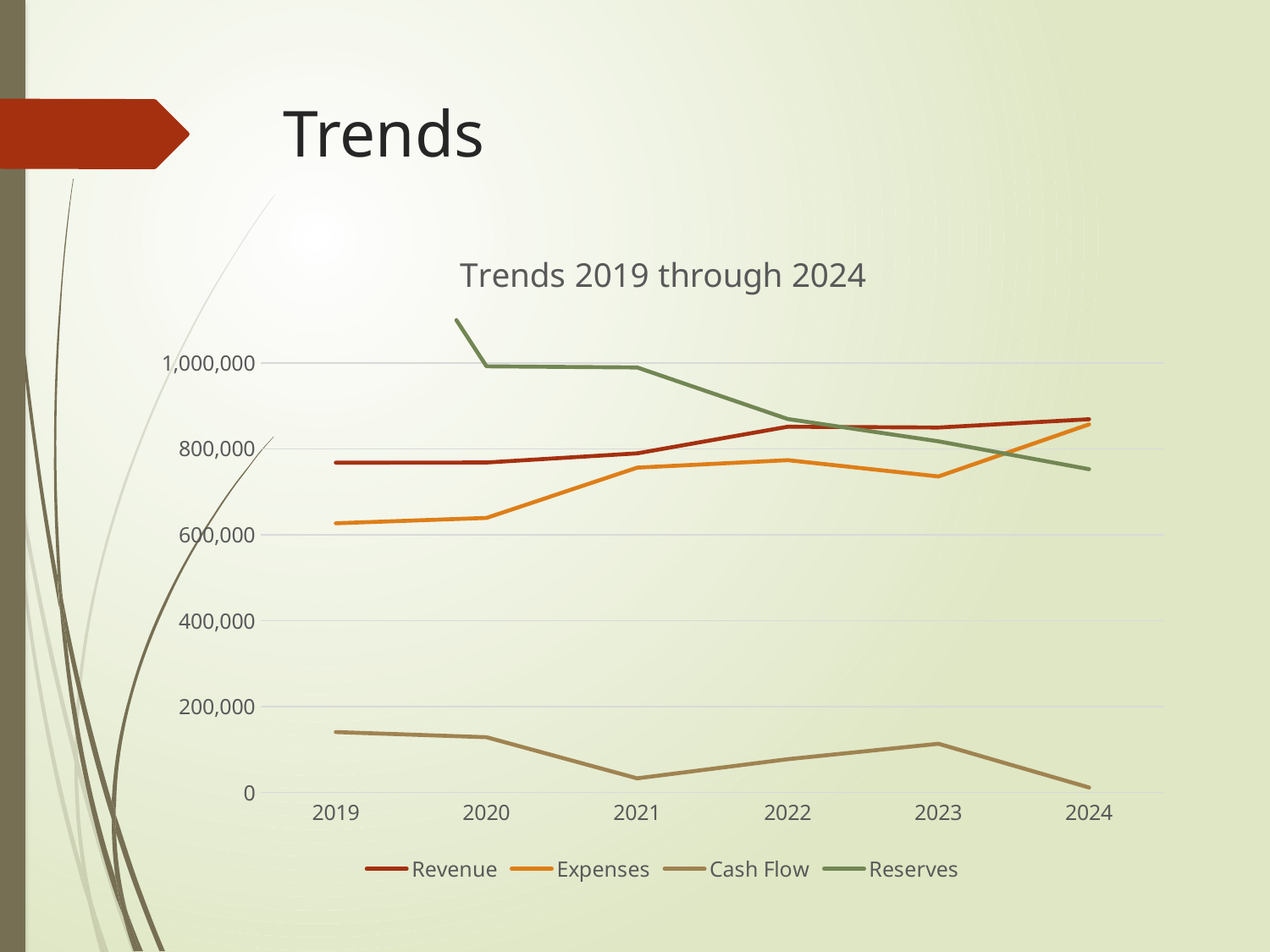
Is the Cash Flow value for 2021 greater or less than 200,000? less In 2021, which is larger, Reserves or Revenue? Reserves Is the Reserves value for 2024 greater or less than 800,000? less Do the Expenses values rise or fall from 2019 to 2024? Rise Is the Revenue value for 2019 greater or less than 800,000? less What kind of chart is shown on the slide? Line chart Which series is shown in green in the legend? Reserves What is the title of the chart? Trends 2019 through 2024 Which series has the lowest value in 2022? Cash Flow How many series does the legend list? 4 Do the Reserves values rise or fall from 2020 to 2024? Fall How many years are shown on the x axis? 6